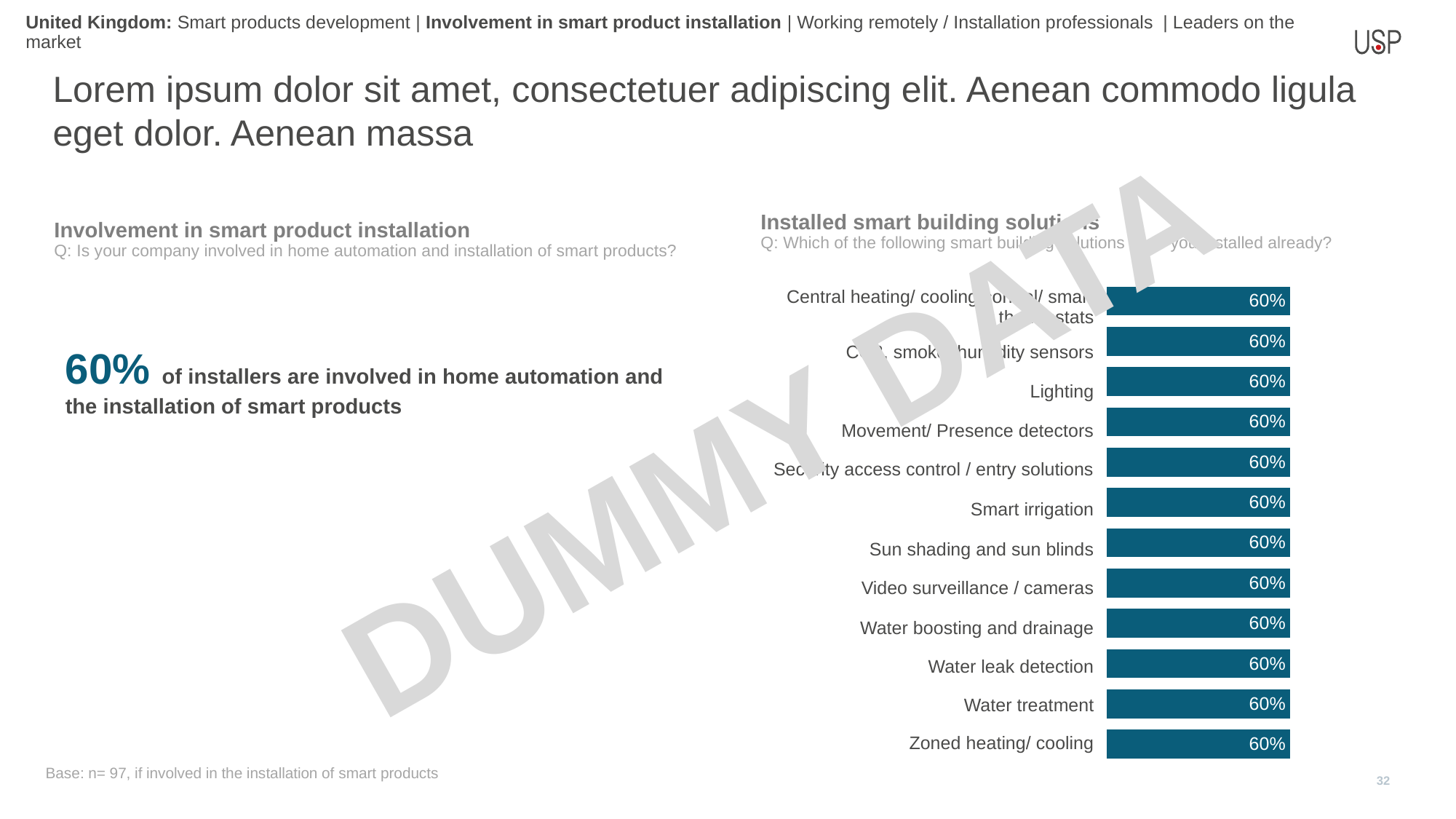
What is the title of the chart on the right side of the slide? Installed smart building solutions What is the difference between the values for Water treatment and Water boosting and drainage in the Installed smart building solutions chart? 0% What is the value for Lighting in the Installed smart building solutions chart? 60% What is the value for Video surveillance / cameras in the Installed smart building solutions chart? 60% What is the base (n) stated at the bottom of the slide for the chart? n= 97 What is the value for Movement/ Presence detectors in the Installed smart building solutions chart? 60% How many categories are shown in the Installed smart building solutions chart? 12 What kind of chart is the Installed smart building solutions chart? Bar chart What is the value for Water leak detection in the Installed smart building solutions chart? 60% What is the value for Zoned heating/ cooling in the Installed smart building solutions chart? 60% What is the value for Smart irrigation in the Installed smart building solutions chart? 60% What is the value for Sun shading and sun blinds in the Installed smart building solutions chart? 60%